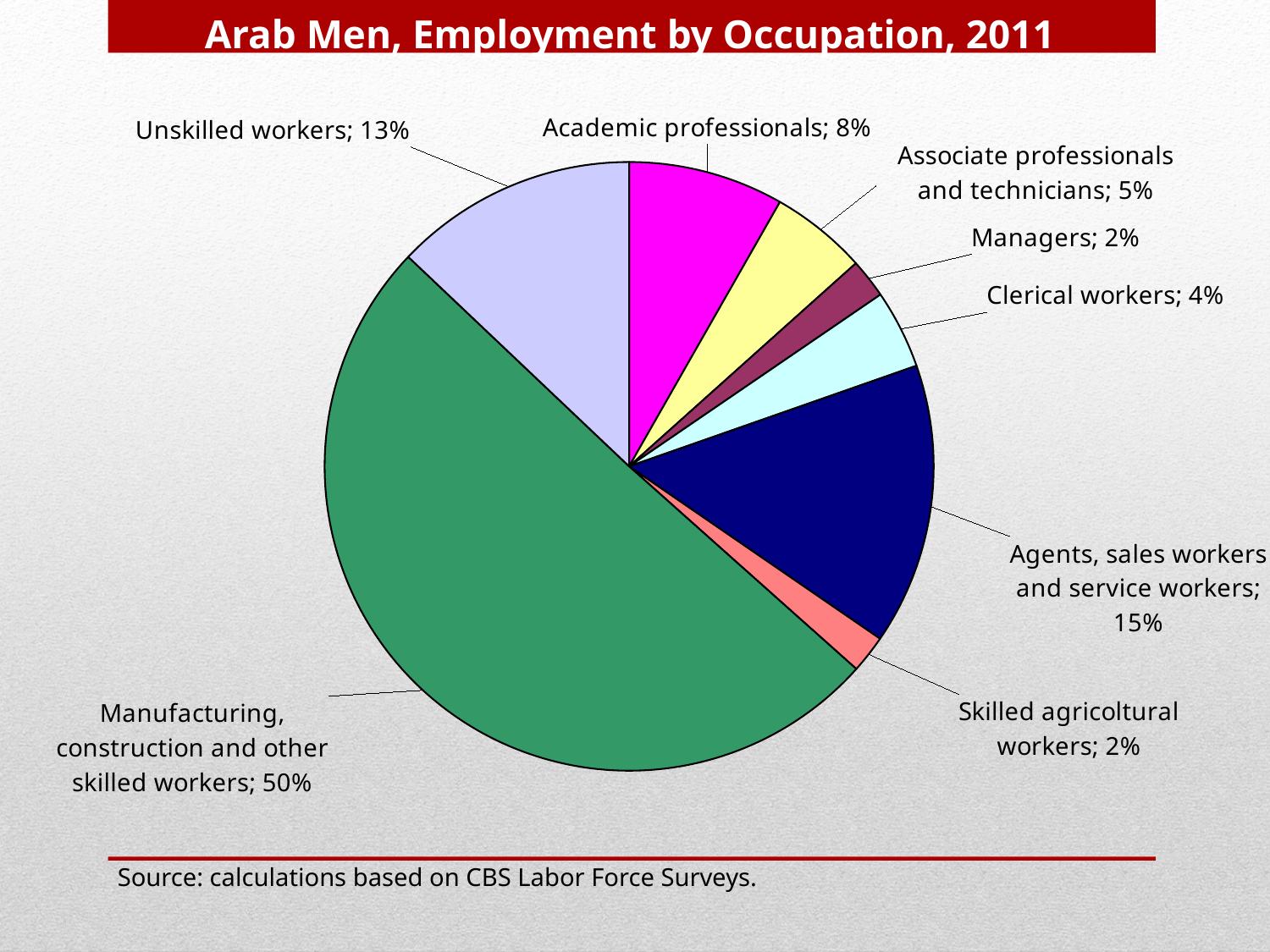
Which is larger, the share for associate professionals and technicians or the share for clerical workers? Associate professionals and technicians What share of Arab men's employment is in manufacturing, construction and other skilled workers? 50% How many occupation categories are shown in the pie chart? 8 What percentage is shown for agents, sales workers and service workers? 15% What is the combined share of managers and skilled agricoltural workers? 4% Which occupation category has the largest share of the pie? Manufacturing, construction and other skilled workers What type of chart is shown on the slide? Pie chart What is the title of the chart? Arab Men, Employment by Occupation, 2011 What is the difference in percentage points between unskilled workers and academic professionals? 5 What percentage is shown for academic professionals? 8% What percentage is shown for unskilled workers? 13% What percentage is shown for clerical workers? 4%